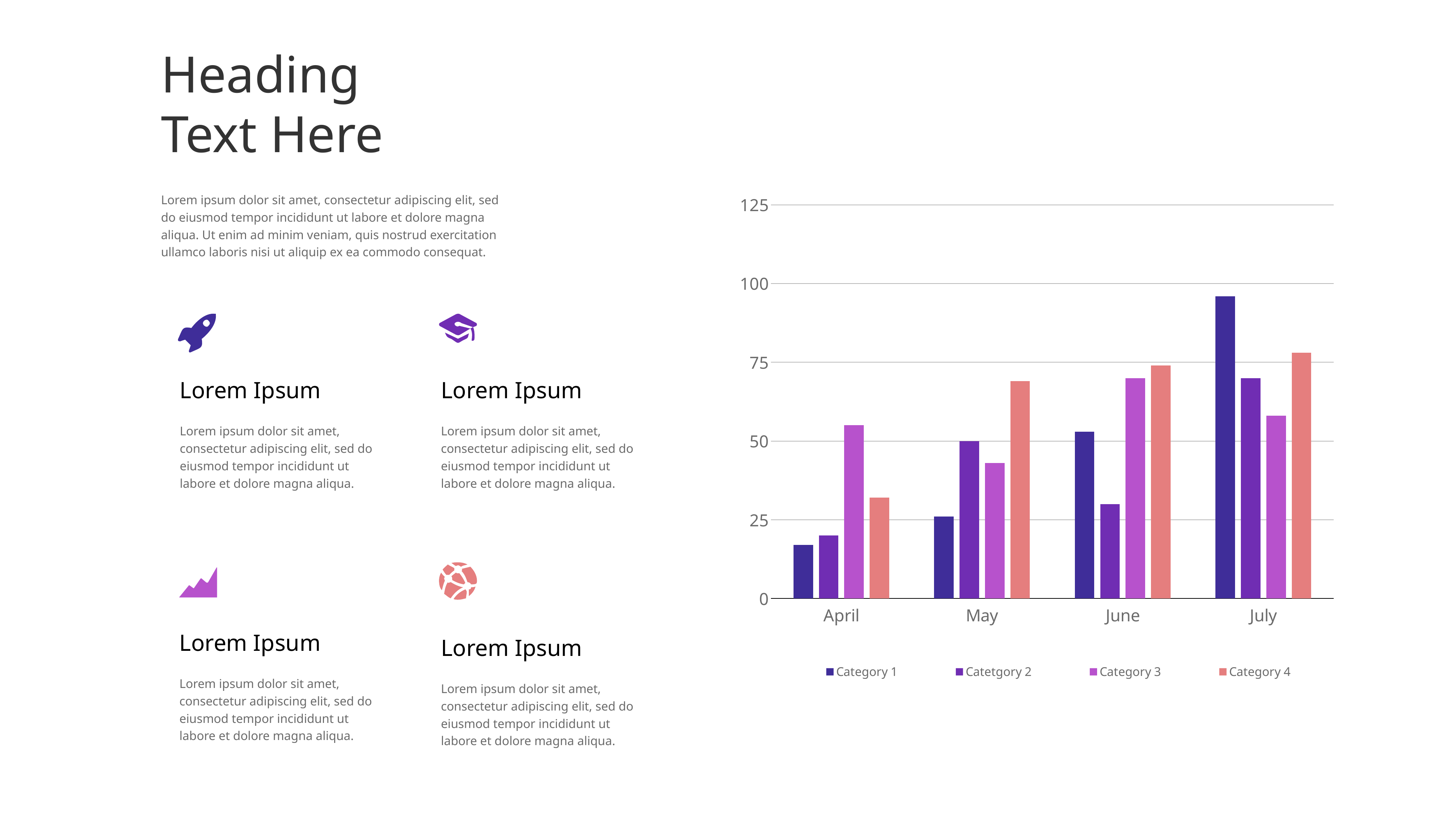
In May, which is larger: Category 4 or Category 1? Category 4 Is the value for Category 1 in April greater or less than 25? less How many series does the chart legend list? 4 Which month is the first category on the x axis? April Is the value for Catetgory 2 in June greater or less than 50? less Is the value for Category 1 in July greater or less than 75? greater In which month is the Category 1 bar the highest? July Do the Category 1 values rise or fall from April to July? rise How many months are shown on the x axis of the chart? 4 What kind of chart is shown on the slide? bar chart In which month is the Category 1 bar the lowest? April